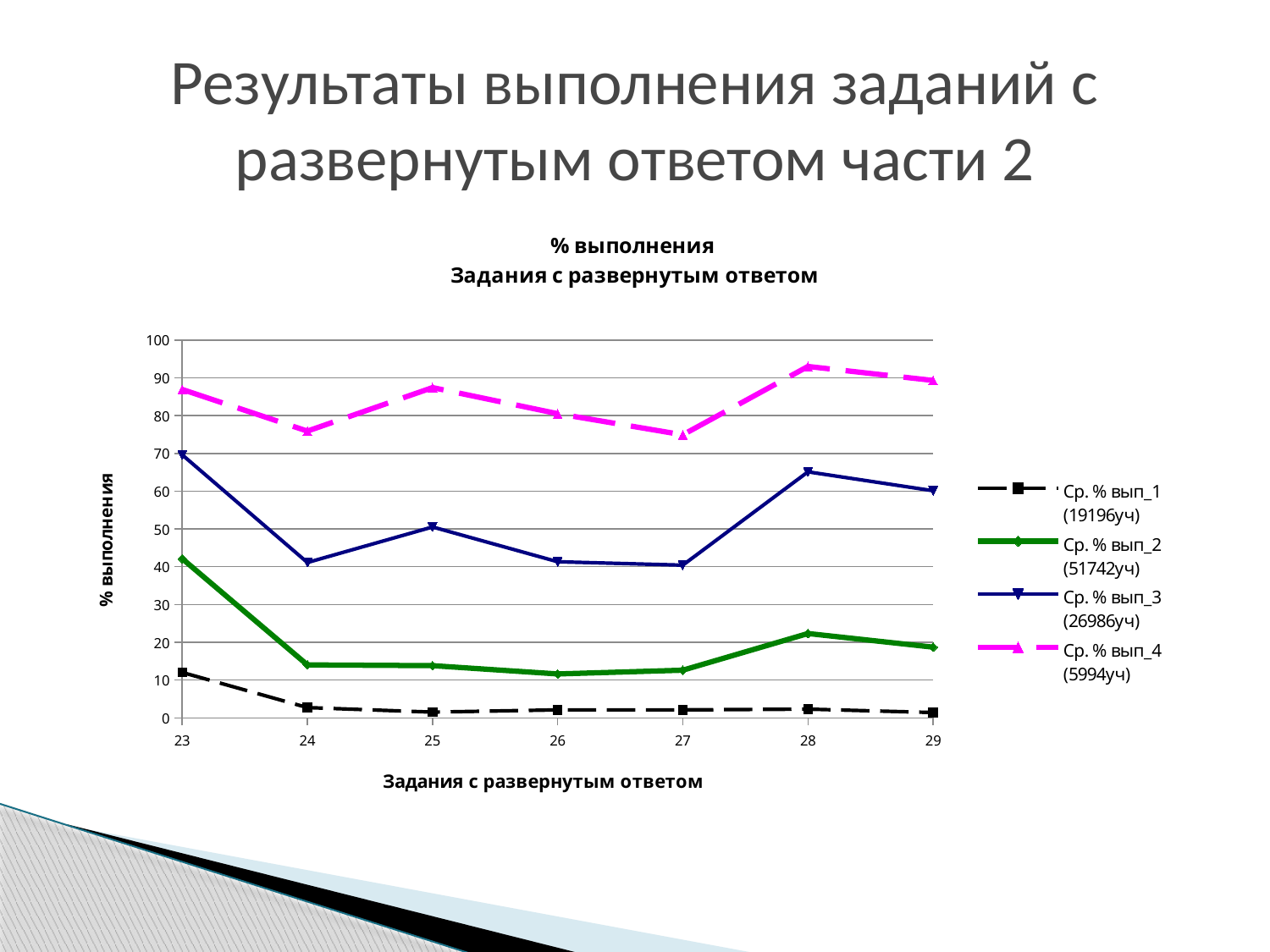
For which task does the series Ср. % вып_3 (26986уч) reach its highest value? 23 Does the series Ср. % вып_1 (19196уч) rise or fall from task 23 to task 24? fall How many tasks (x-axis categories) are plotted on the chart? 7 For task 25, which series has the larger value: Ср. % вып_3 (26986уч) or Ср. % вып_2 (51742уч)? Ср. % вып_3 (26986уч) For which task does the series Ср. % вып_2 (51742уч) reach its highest value? 23 How many series does the legend list? 4 Is the value of Ср. % вып_3 (26986уч) for task 23 greater or less than 60? greater What is the title of the vertical axis of the chart? % выполнения Is the value of Ср. % вып_1 (19196уч) for task 25 greater or less than 10? less What kind of chart is shown on the slide? line chart For which task does the series Ср. % вып_4 (5994уч) reach its highest value? 28 Is the value of Ср. % вып_4 (5994уч) for task 27 greater or less than 80? less